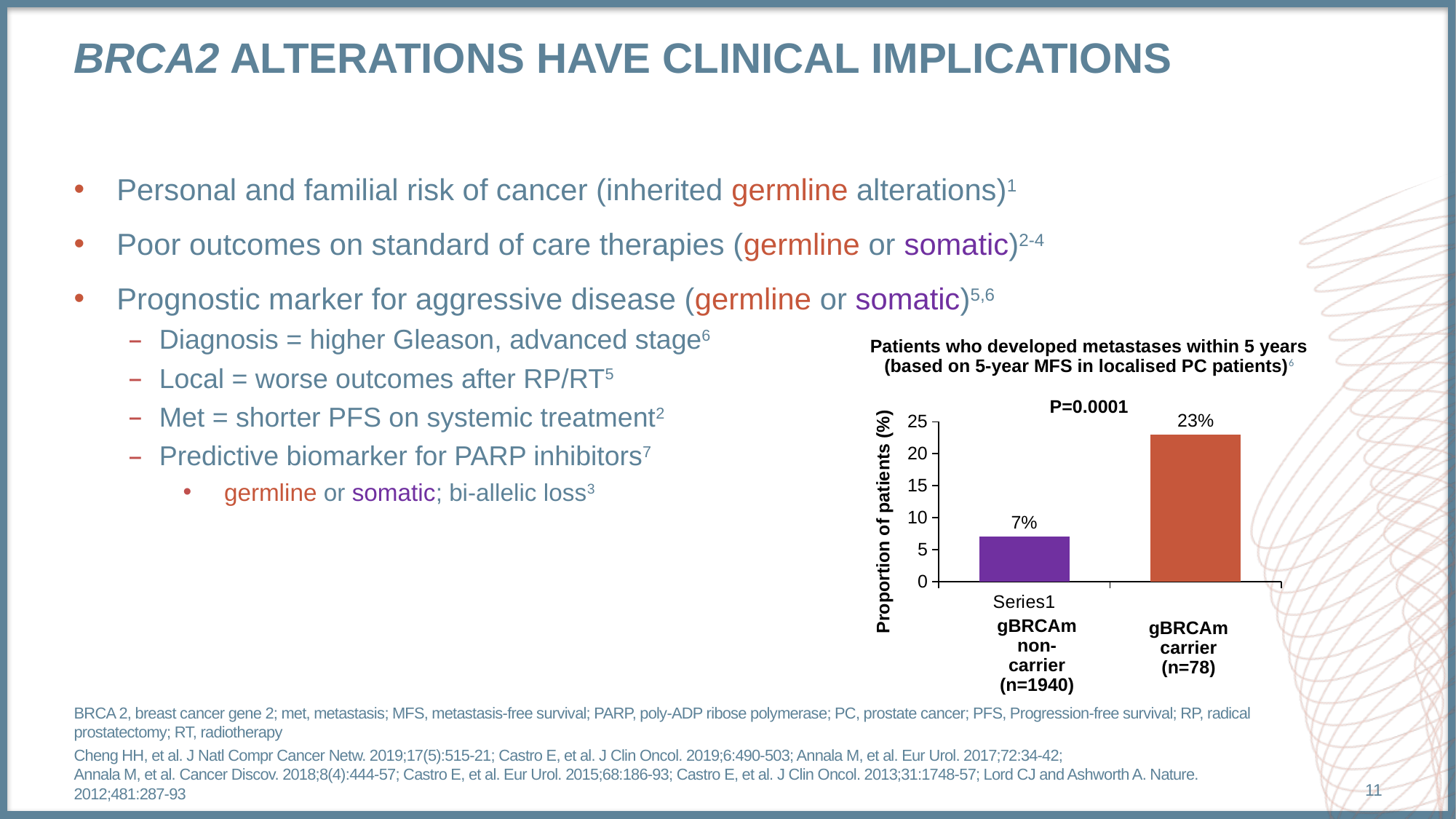
How many patients were in the gBRCAm carrier group according to the chart's category label? n=78 What is the label of the y axis of the chart? Proportion of patients (%) Which group has the lower proportion of patients who developed metastases within 5 years? gBRCAm non-carrier What proportion of gBRCAm carriers developed metastases within 5 years? 23% What is the P value shown on the chart? P=0.0001 Is the value for gBRCAm carriers greater or less than 20? greater What proportion of gBRCAm non-carriers developed metastases within 5 years? 7% Is the value for gBRCAm non-carriers greater or less than 10? less What is the difference in percentage points between the gBRCAm carrier and gBRCAm non-carrier bars? 16 How many bars are shown in the chart? 2 Which group has the higher proportion of patients who developed metastases within 5 years? gBRCAm carrier What type of chart is shown on the slide? Bar chart